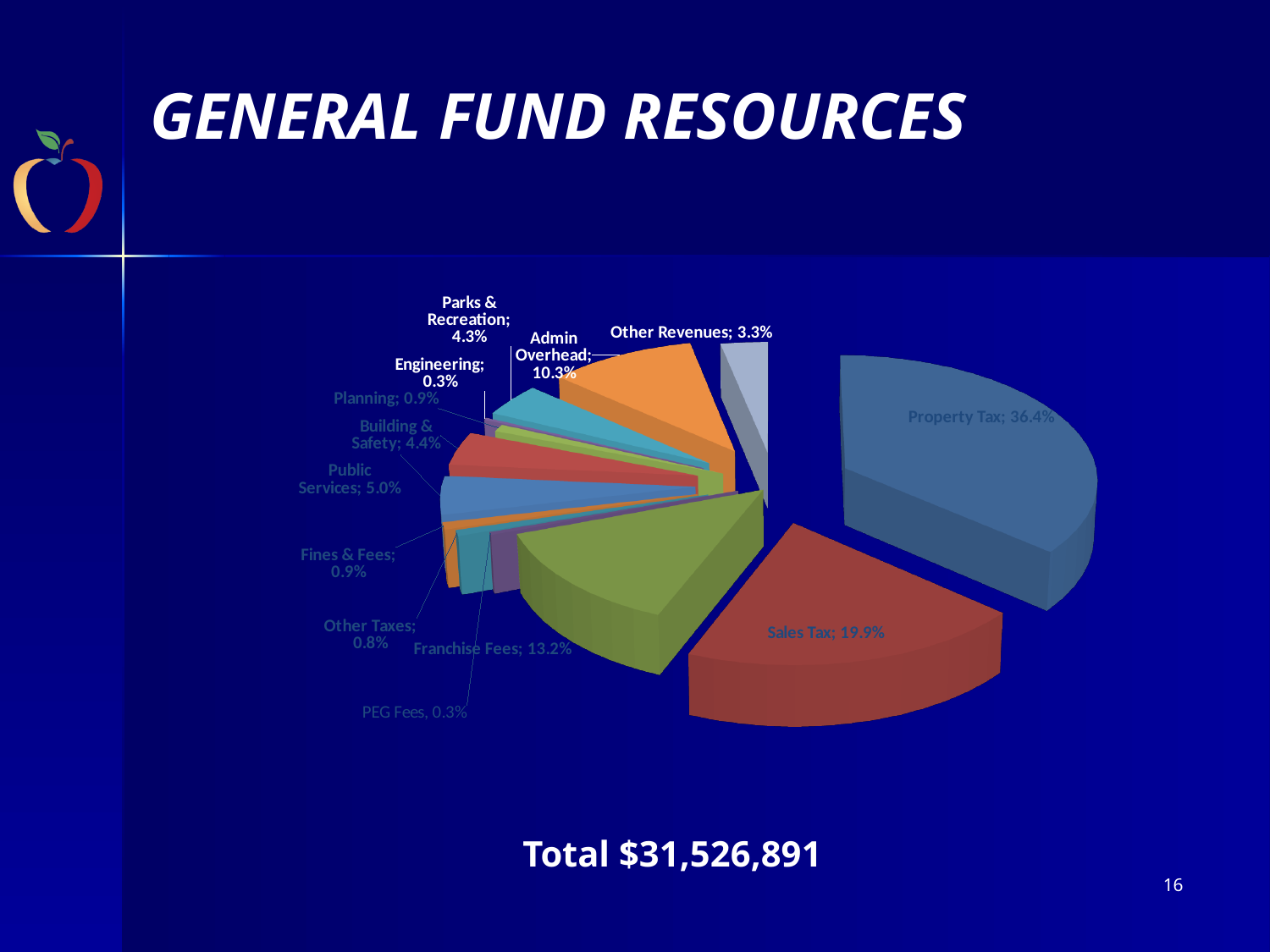
What percentage is shown for Franchise Fees? 13.2% How many slices (categories) does the pie chart have? 13 Which category has the largest slice of the pie? Property Tax What percentage of the pie is Sales Tax? 19.9% What total amount is stated below the chart? $31,526,891 How many percentage points larger is Property Tax than Sales Tax? 16.5 Which is larger, Public Services or Other Revenues? Public Services What type of chart is shown on the slide? Pie chart What share of General Fund Resources comes from Property Tax? 36.4% What share does Public Services represent? 5.0% What is the share for Admin Overhead? 10.3% Which is larger, Franchise Fees or Admin Overhead? Franchise Fees